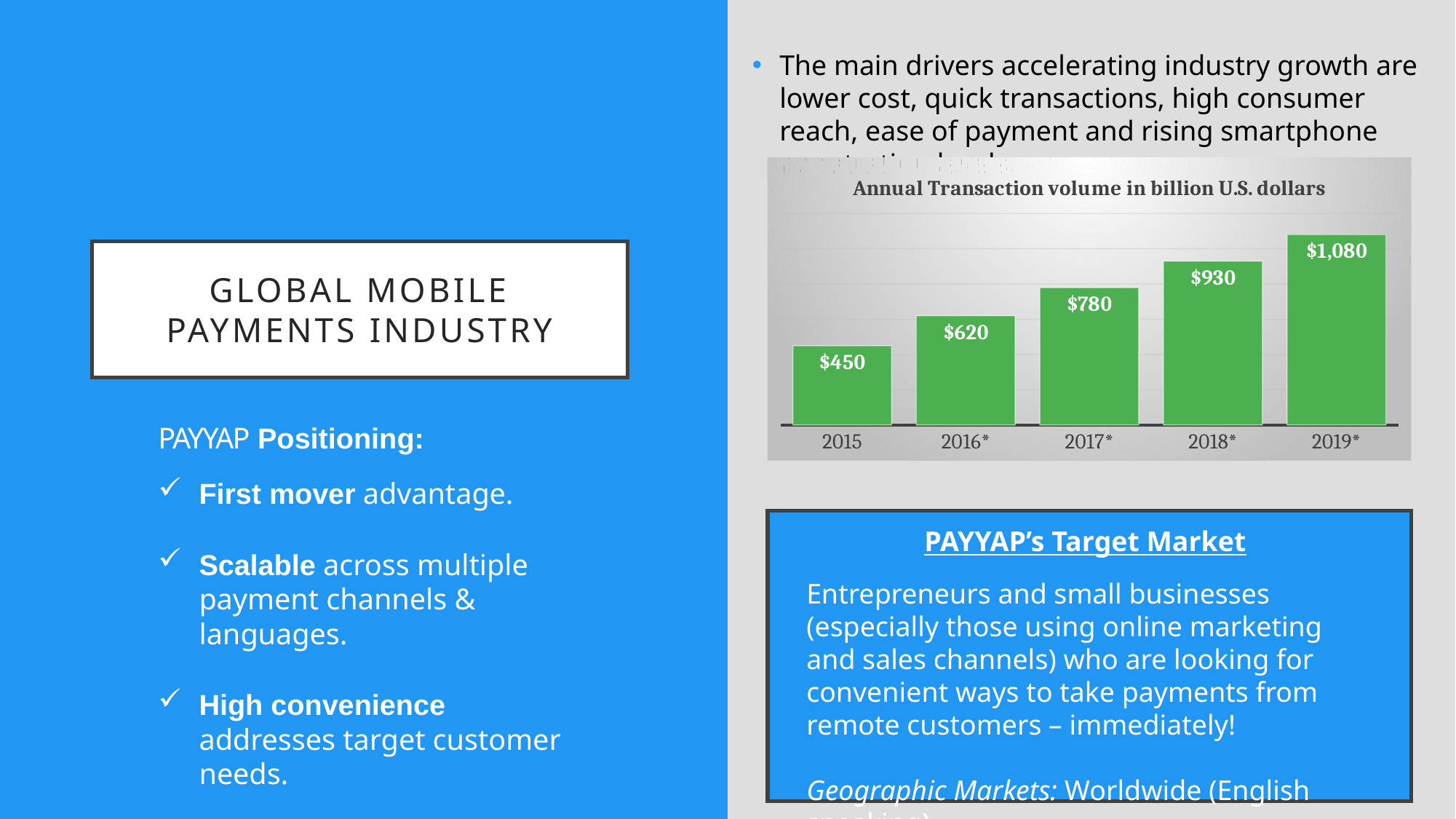
What is the annual transaction volume shown for 2015? $450 Which year has the highest annual transaction volume? 2019* What kind of chart is shown on the slide? Bar chart Which year has the lowest annual transaction volume? 2015 Which is larger, the value for 2016* or the value for 2017*? 2017* What is the difference between the values for 2019* and 2015? $630 How many years are shown on the chart? 5 What is the title of the chart? Annual Transaction volume in billion U.S. dollars What value is shown for 2017*? $780 What value is shown for 2019*? $1,080 What is the difference between the values for 2018* and 2016*? $310 Do the values rise or fall from 2015 to 2019*? Rise